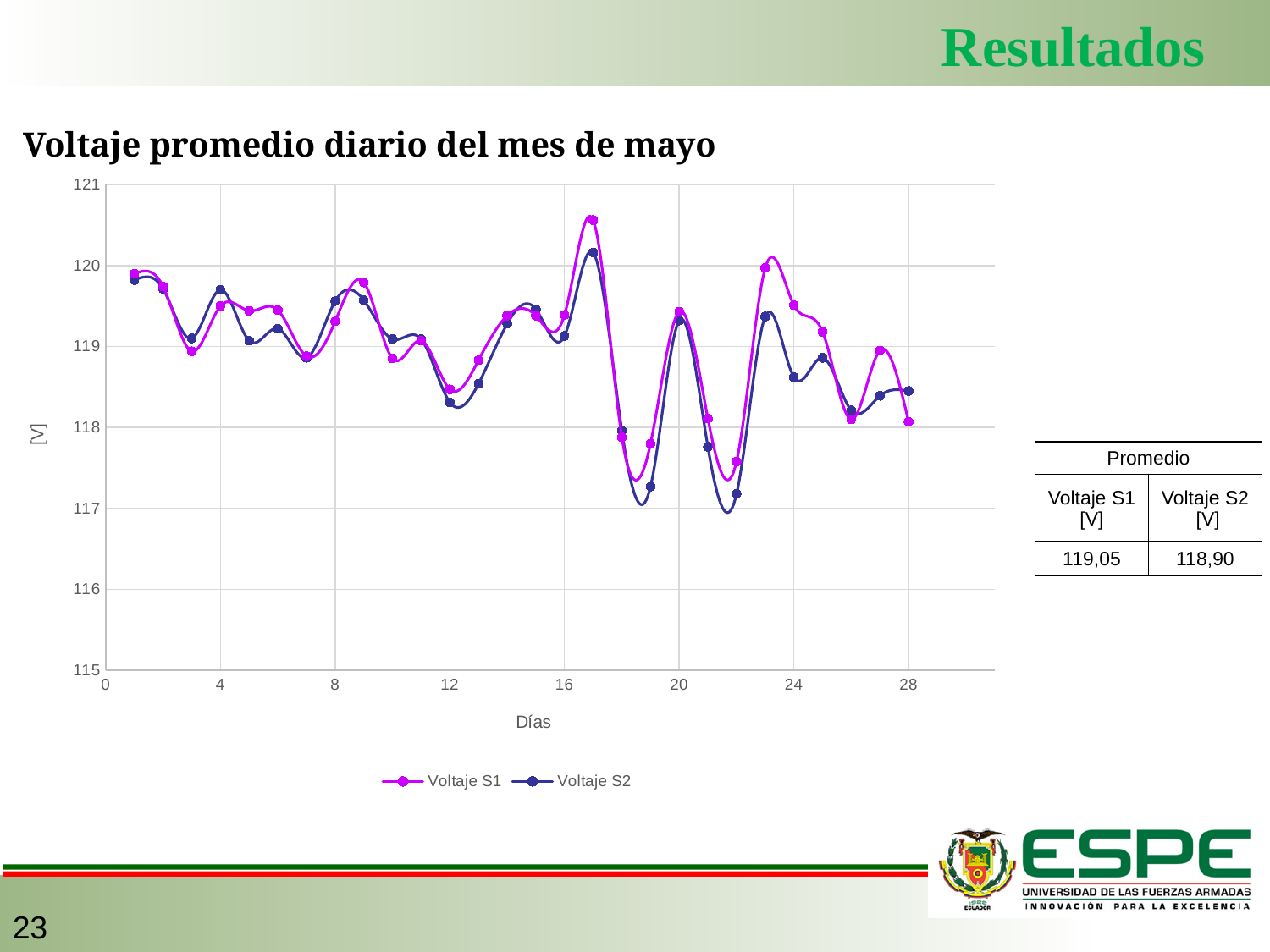
What is the title of the chart? Voltaje promedio diario del mes de mayo Is the value of Voltaje S2 on day 19 greater or less than 118? less What kind of chart is shown on the slide? line chart What are the two series named in the chart legend? Voltaje S1 and Voltaje S2 On which day does Voltaje S1 reach its highest value? 17 On day 4, which series has the larger value, Voltaje S1 or Voltaje S2? Voltaje S2 How many days (data points) are plotted for each series in the chart? 28 On which day does Voltaje S2 reach its highest value? 17 How many series does the legend of the chart list? 2 Is the value of Voltaje S1 on day 17 greater or less than 120? greater Is the value of Voltaje S1 on day 12 greater or less than 119? less According to the Promedio table next to the chart, what is the average Voltaje S1 in volts? 119,05